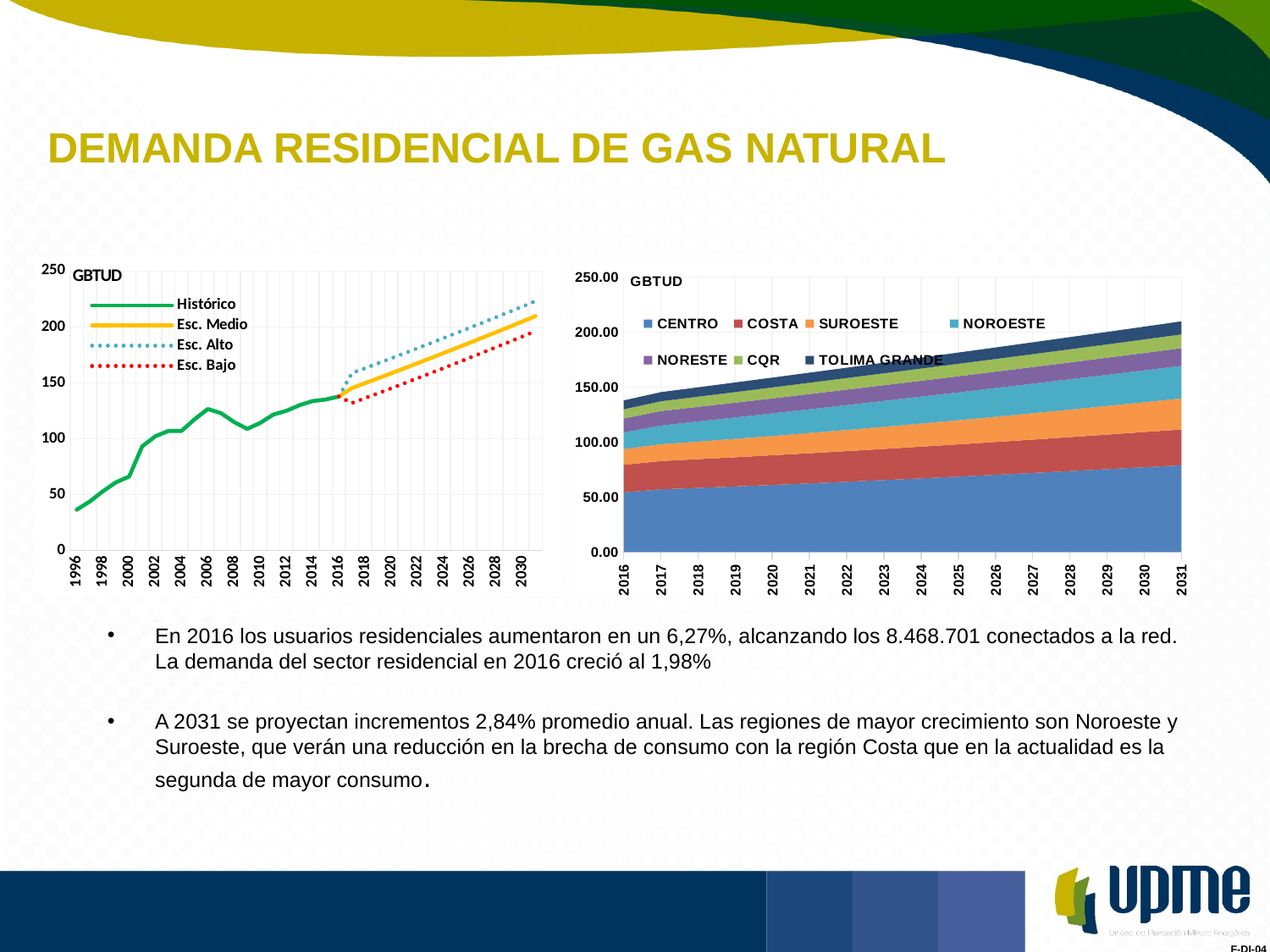
In the left chart, which scenario line is highest in 2030: Esc. Alto or Esc. Bajo? Esc. Alto What type of chart is the chart on the right of the slide? stacked area chart In the left chart, is the Esc. Bajo value for 2018 greater or less than 150? less What type of chart is the chart on the left of the slide? line chart In the left chart, does the Histórico series generally rise or fall from 1996 to 2016? rise In the right chart, which region has the largest area (highest consumption) across the period? CENTRO In the left chart, is the Histórico value for 1996 greater or less than 50? less In the left chart, is the Histórico value for 2006 greater or less than 100? greater How many series does the legend of the left chart list? 4 How many series does the legend of the right chart list? 7